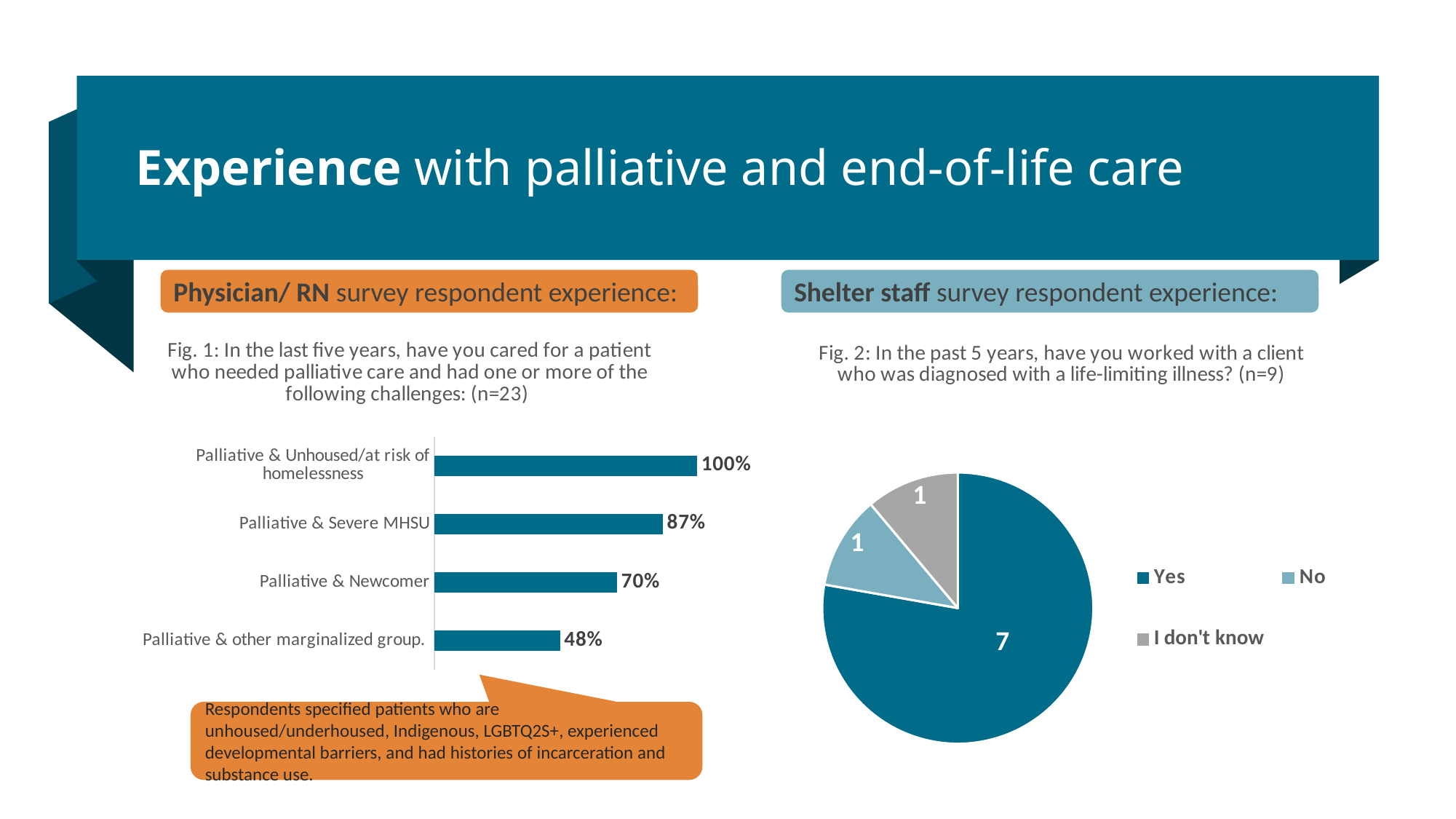
In Fig. 2 (the pie chart), how many respondents answered Yes? 7 In Fig. 1 (the bar chart), how many categories are plotted? 4 In Fig. 1 (the bar chart), which category has the highest value? Palliative & Unhoused/at risk of homelessness In Fig. 2 (the pie chart), which response has the largest slice? Yes In Fig. 2 (the pie chart), how many entries does the legend list? 3 In Fig. 1 (the bar chart), what percentage is shown for Palliative & Newcomer? 70% What kind of chart is Fig. 2 on the right of the slide? Pie chart In Fig. 1 (the bar chart), what is the difference between the values for Palliative & Severe MHSU and Palliative & other marginalized group.? 39% In Fig. 2 (the pie chart), how many respondents answered No? 1 In Fig. 1 (the bar chart), what percentage is shown for Palliative & Severe MHSU? 87% What kind of chart is Fig. 1 on the left of the slide? Bar chart In Fig. 1 (the bar chart), which category has the lowest value? Palliative & other marginalized group.